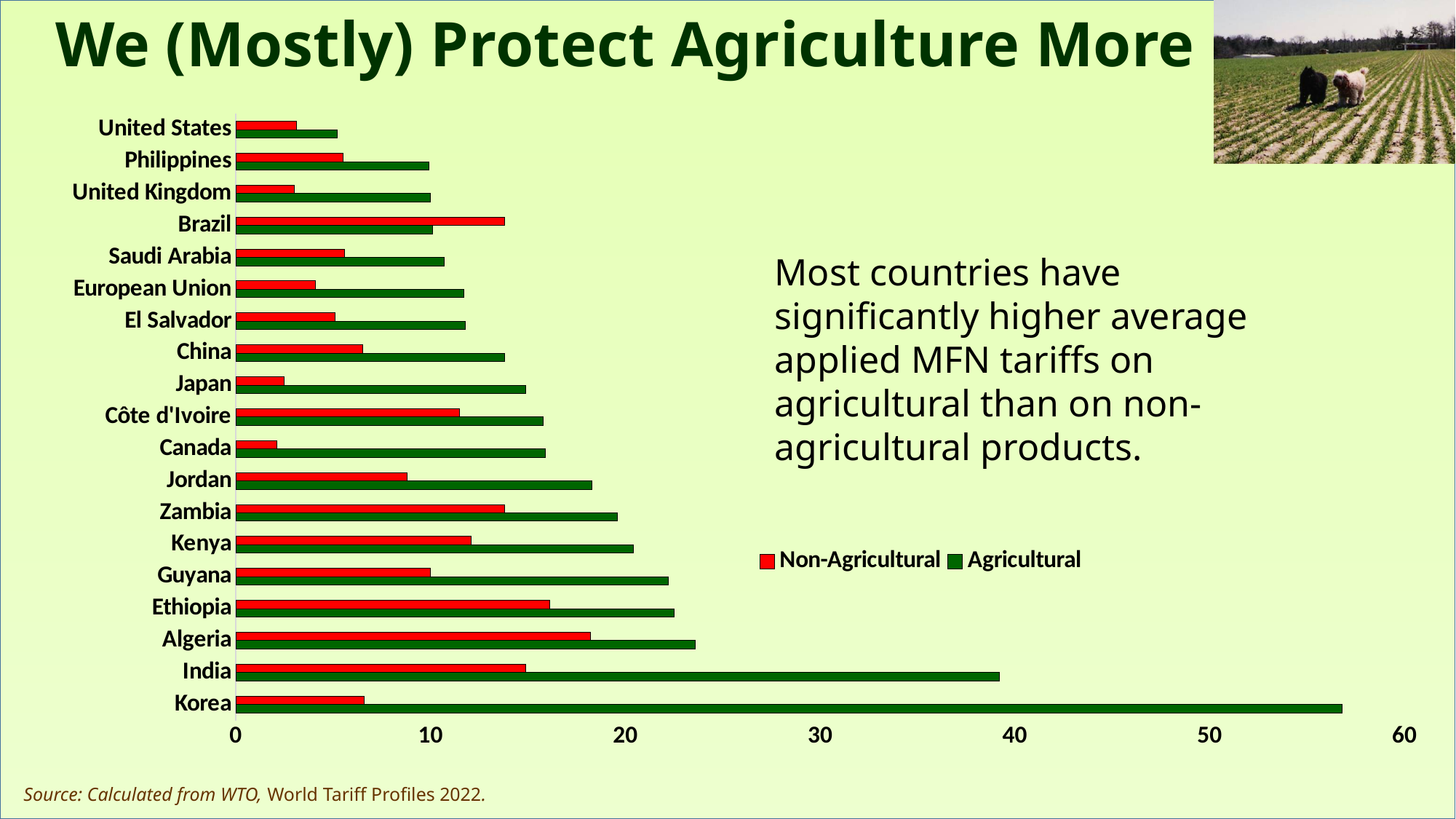
Is the Agricultural value for India greater or less than 30? greater Which country has the highest Agricultural tariff? Korea Is the Non-Agricultural value for Algeria greater or less than 20? less How many series does the legend list? 2 Is the Non-Agricultural value for Canada greater or less than 10? less How many countries are shown on the chart? 19 For Brazil, which is larger: the Agricultural or the Non-Agricultural tariff? Non-Agricultural Which country has the highest Non-Agricultural tariff? Algeria What colour are the Agricultural bars? green Which country has the lowest Agricultural tariff? United States What kind of chart is shown on the slide? bar chart